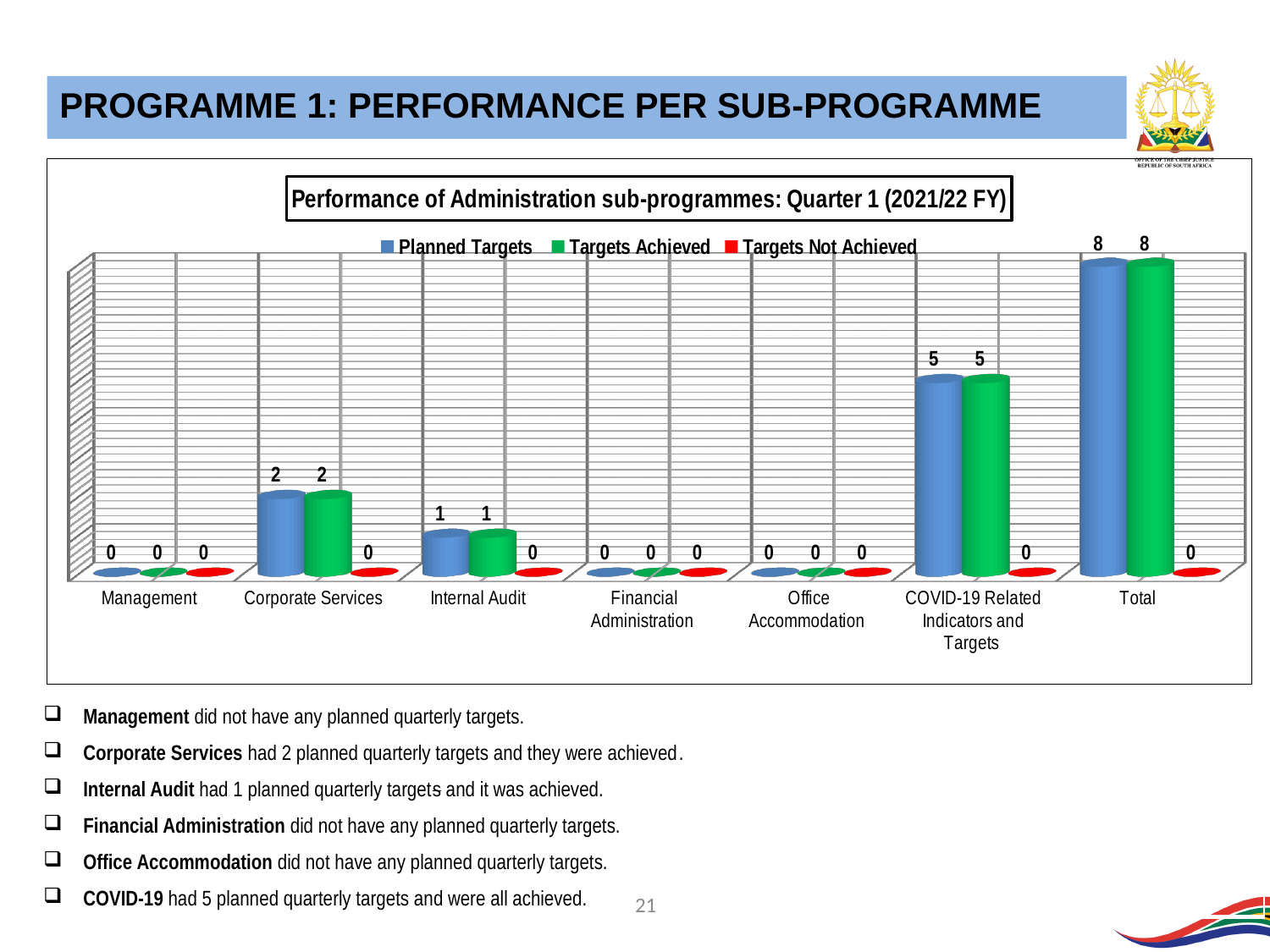
Which colour represents Targets Not Achieved in the legend? Red What is the title of the chart? Performance of Administration sub-programmes: Quarter 1 (2021/22 FY) How many categories are shown on the x axis? 7 What is the value of Planned Targets for COVID-19 Related Indicators and Targets? 5 What is the value of Targets Not Achieved for Internal Audit? 0 What kind of chart is shown on the slide? Bar chart What is the difference between Planned Targets for Total and Planned Targets for COVID-19 Related Indicators and Targets? 3 Which category has the highest Planned Targets value? Total Which is larger: Targets Achieved for Corporate Services or Targets Achieved for Internal Audit? Corporate Services What is the value of Targets Achieved for Corporate Services? 2 What is the value of Planned Targets for Total? 8 How many series does the legend list? 3